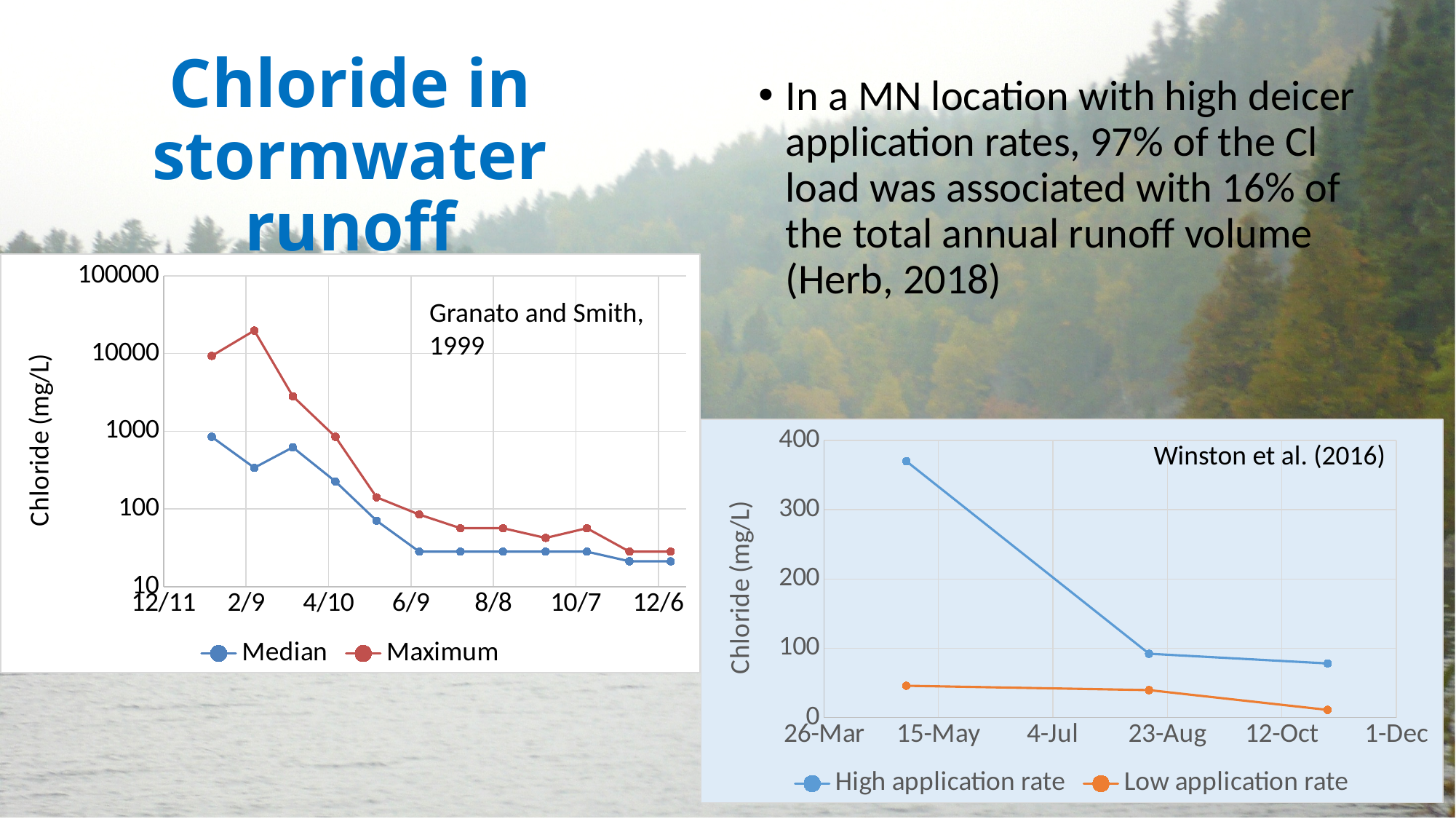
In the Winston et al. (2016) chart, is the first value of the Low application rate series greater or less than 100? less In the Winston et al. (2016) chart, how many data points does the High application rate series have? 3 What kind of chart is the Granato and Smith, 1999 chart on the left? line chart What is the y-axis label of the Winston et al. (2016) chart? Chloride (mg/L) In the Granato and Smith, 1999 chart, is the Median value at 6/9 greater or less than 100? less In the Winston et al. (2016) chart, does the High application rate series rise or fall over time? fall What are the two series named in the legend of the Granato and Smith, 1999 chart? Median and Maximum How many series does the legend of the Winston et al. (2016) chart list? 2 In the Winston et al. (2016) chart, which series has the higher values throughout, High application rate or Low application rate? High application rate In the Winston et al. (2016) chart, is the first value of the High application rate series greater or less than 300? greater